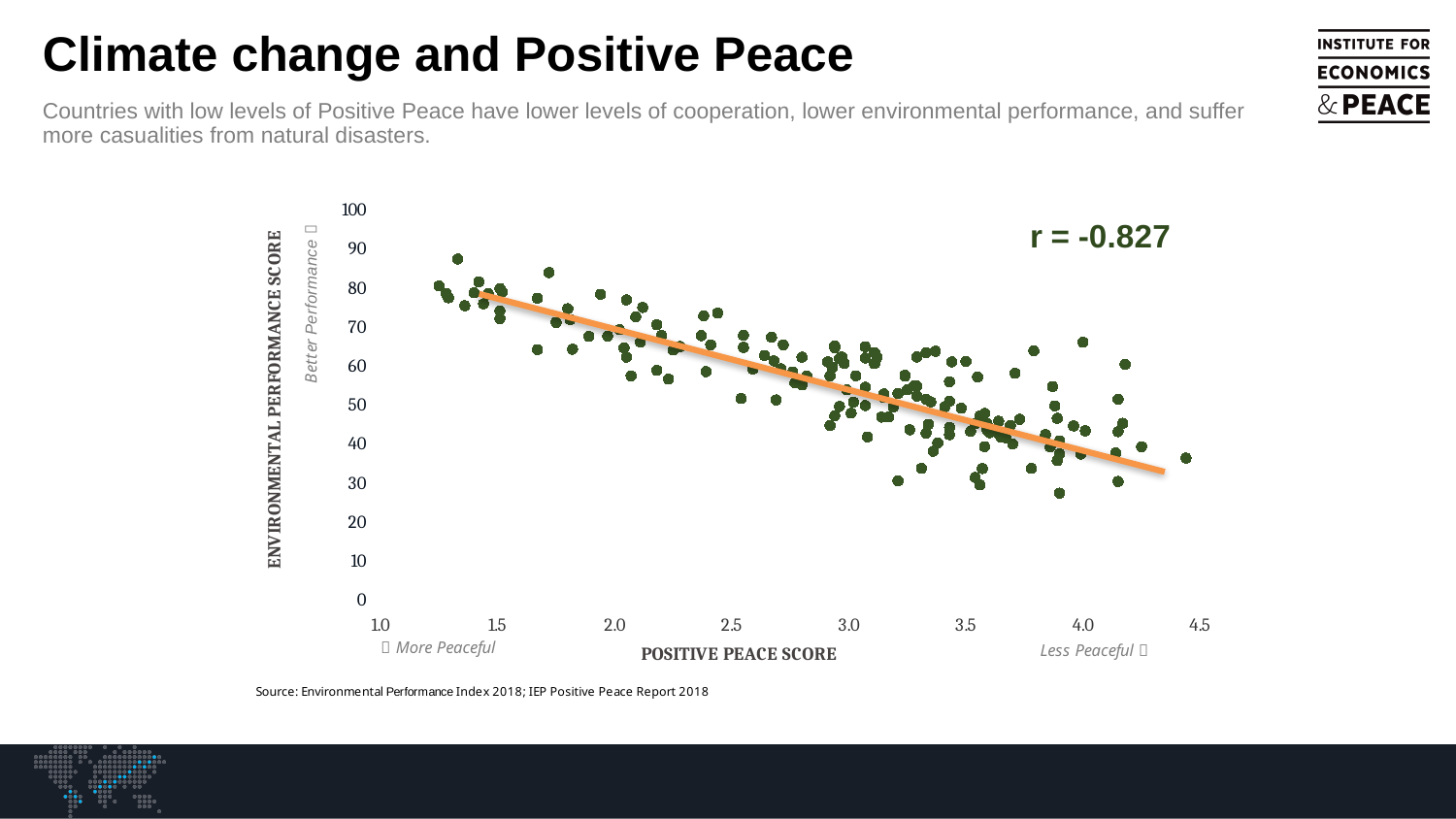
Is the lowest plotted point on the chart greater or less than 40 on the Environmental Performance Score axis? less What kind of chart is shown on the slide? scatter chart Is the highest plotted point on the chart greater or less than 80 on the Environmental Performance Score axis? greater Is the value of the orange trend line at a Positive Peace Score of 1.5 greater or less than 70? greater What correlation coefficient (r) is printed on the chart? r = -0.827 As the Positive Peace Score increases along the x axis, do the Environmental Performance Scores generally rise or fall? fall What is the title of the x axis of the chart? POSITIVE PEACE SCORE Is the trend line value at a Positive Peace Score of 2.0 larger or smaller than its value at 3.5? larger